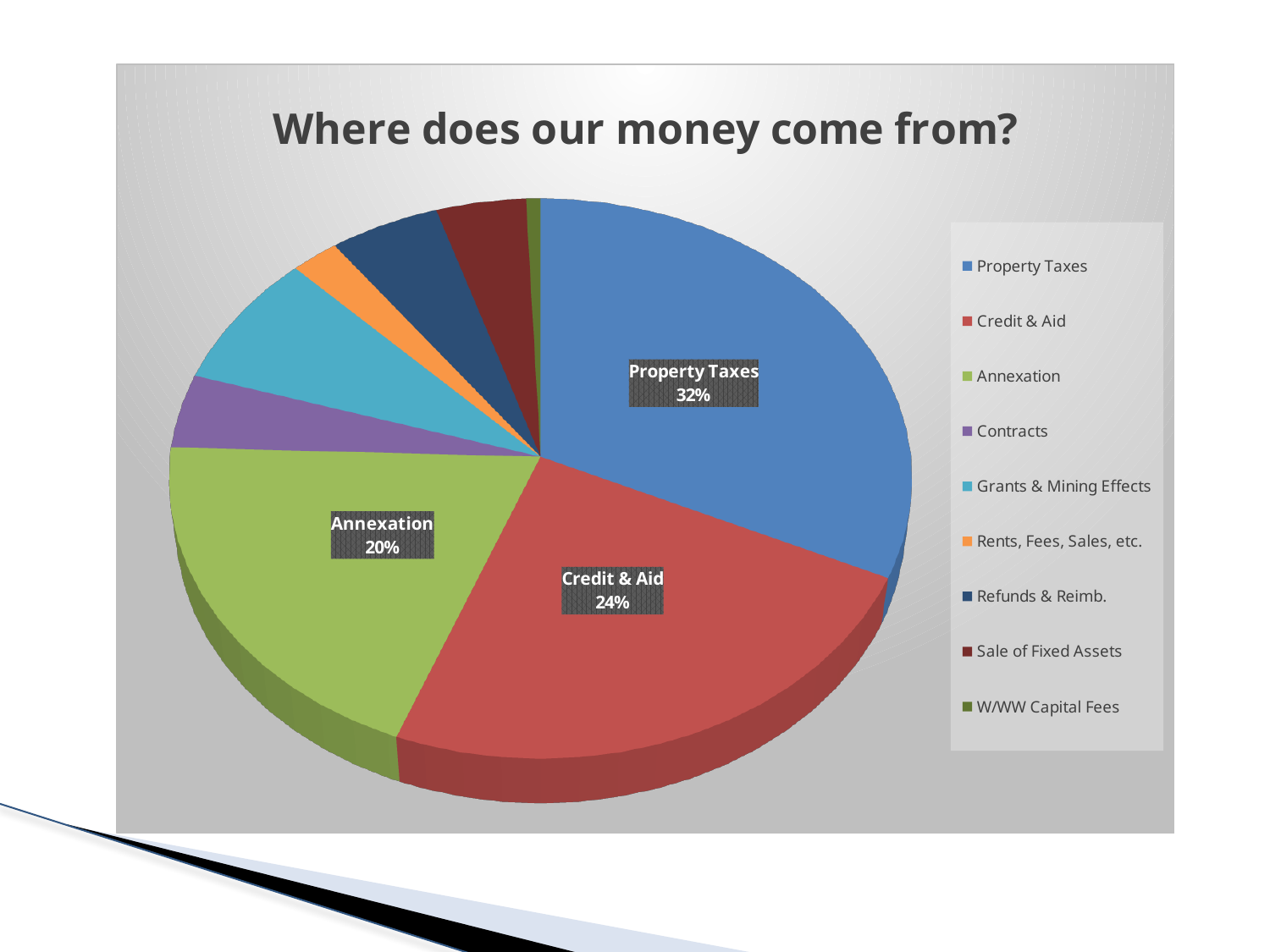
What percentage is shown for Annexation? 20% What type of chart is shown on the slide? Pie chart What share of the pie does Property Taxes represent? 32% How many percentage points larger is Property Taxes than Credit & Aid? 8% Which is larger, the Annexation slice or the Credit & Aid slice? Credit & Aid What combined share do Property Taxes, Credit & Aid and Annexation make up together? 76% How many categories does the legend list? 9 Which category has the largest slice of the pie? Property Taxes Which category has the smallest slice of the pie? W/WW Capital Fees What percentage is shown for Credit & Aid? 24% What is the title of the chart? Where does our money come from? What is the difference between the Credit & Aid share and the Annexation share? 4%